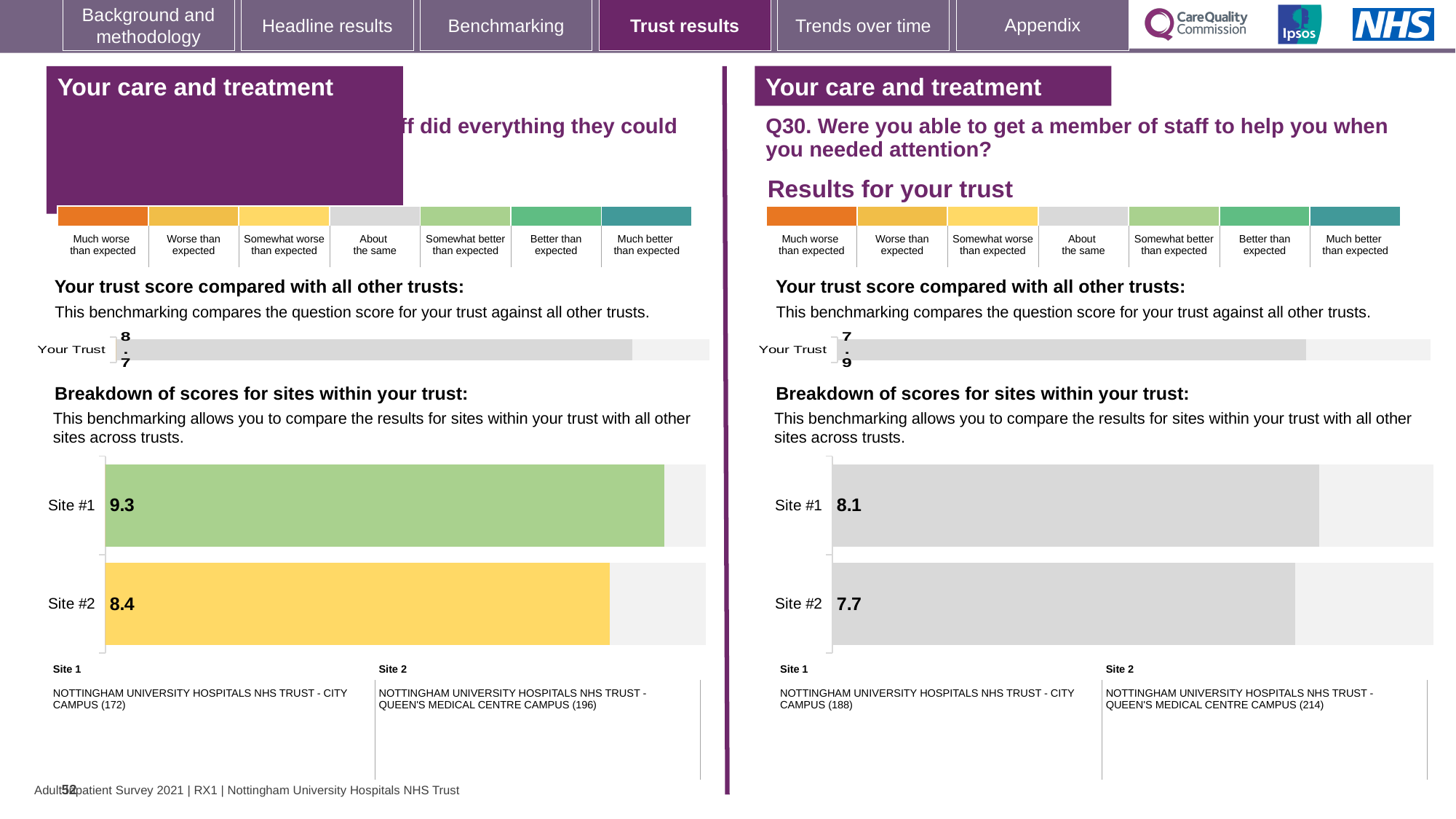
In the right-hand (Q30) site breakdown chart, which site has the lower score? Site #2 In the right-hand (Q30) site breakdown chart, what is the difference between the Site #1 and Site #2 scores? 0.4 What type of chart is the left-hand site breakdown chart? Bar chart In the right-hand (Q30) 'Your trust score compared with all other trusts' chart, what is the score for Your Trust? 7.9 In the left-hand site breakdown chart, what is the score for Site #1? 9.3 In the right-hand (Q30) site breakdown chart, what is the score for Site #2? 7.7 In the left-hand site breakdown chart, what is the difference between the Site #1 and Site #2 scores? 0.9 In the left-hand 'Your trust score compared with all other trusts' chart, what is the score for Your Trust? 8.7 In the left-hand site breakdown chart, what is the score for Site #2? 8.4 In the left-hand site breakdown chart, which site has the higher score? Site #1 How many sites are shown in the right-hand (Q30) site breakdown chart? 2 In the right-hand (Q30) site breakdown chart, what is the score for Site #1? 8.1